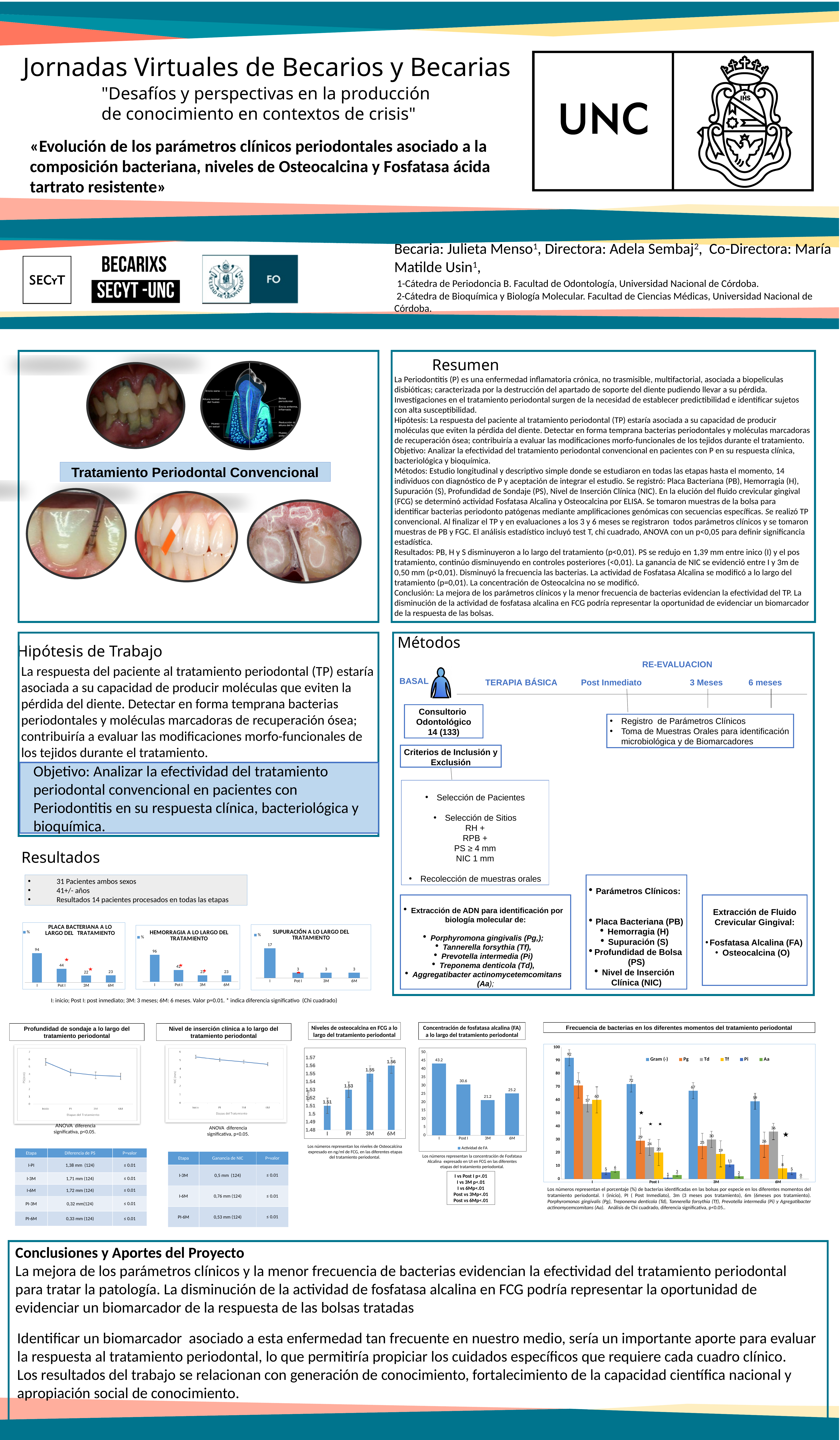
In the chart 'HEMORRAGIA A LO LARGO DEL TRATAMIENTO', what is the value for Post I? 42 In the chart 'PLACA BACTERIANA A LO LARGO DEL TRATAMIENTO', what is the value for I? 94 In the chart 'HEMORRAGIA A LO LARGO DEL TRATAMIENTO', which stage has the highest value? I In the chart 'Concentración de fosfatasa alcalina (FA) a lo largo del tratamiento periodontal', what is the value for I? 43.2 In the chart 'Niveles de osteocalcina en FCG a lo largo del tratamiento periodontal', do the values rise or fall from I to 6M? rise In the chart 'PLACA BACTERIANA A LO LARGO DEL TRATAMIENTO', what is the difference between the values for I and Post I? 50 In the chart 'SUPURACIÓN A LO LARGO DEL TRATAMIENTO', what is the value for I? 17 How many series does the legend list in the chart 'Frecuencia de bacterias en los diferentes momentos del tratamiento periodontal'? 6 How many stages are shown on the x axis of the chart 'SUPURACIÓN A LO LARGO DEL TRATAMIENTO'? 4 In the chart 'Concentración de fosfatasa alcalina (FA) a lo largo del tratamiento periodontal', which stage has the lowest value? 3M In the chart 'Frecuencia de bacterias en los diferentes momentos del tratamiento periodontal', what is the value for Gram (-) at I? 92 In the chart 'Niveles de osteocalcina en FCG a lo largo del tratamiento periodontal', what is the value for 6M? 1.56